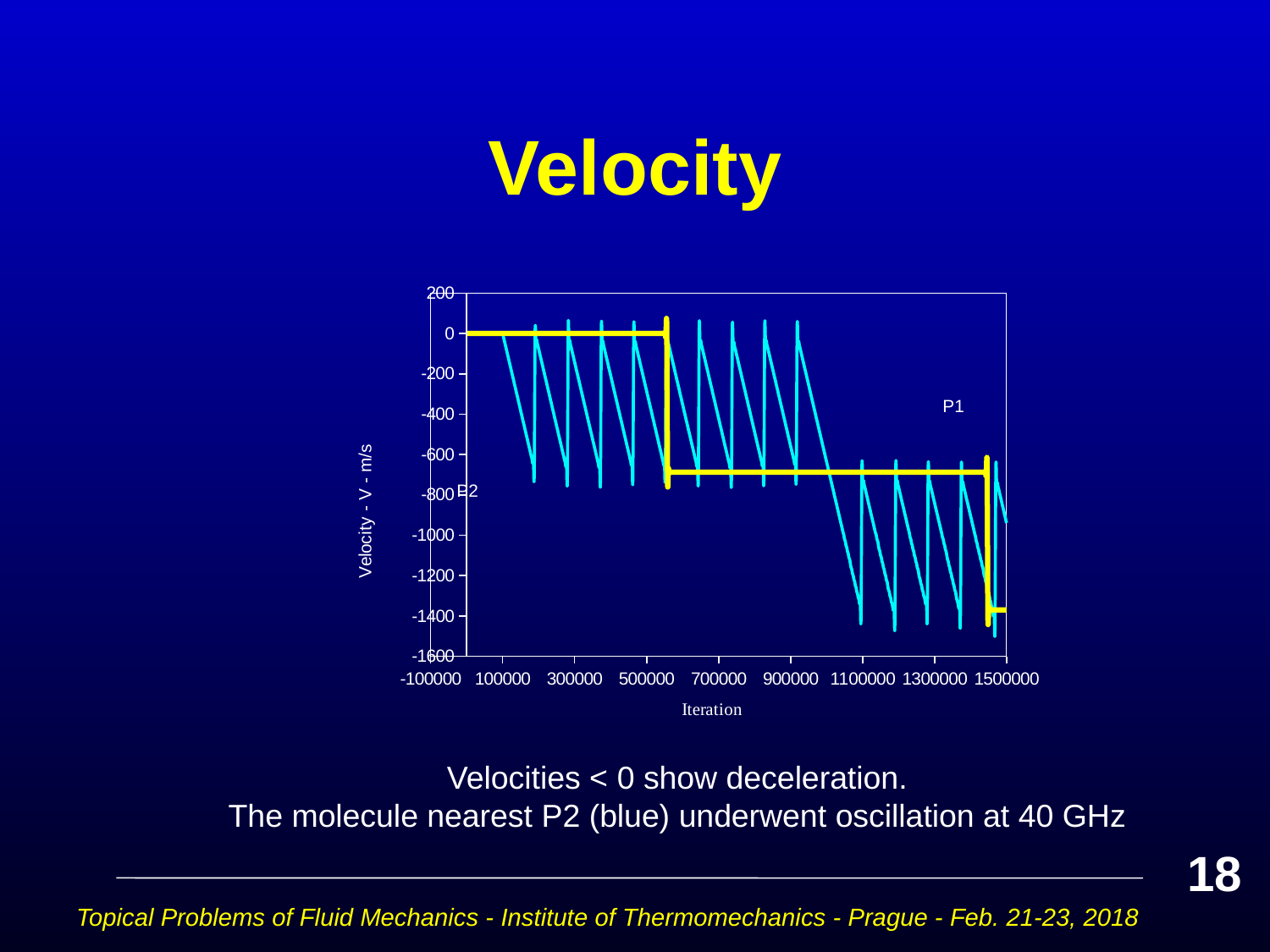
How many series are plotted in the chart? 2 What type of chart is shown on the slide? line chart Is the value of P1 at iteration 300000 greater or less than -200? greater Is the lowest value reached by P2 greater or less than -1200? less Does the P1 series rise or fall as the iteration increases? fall Is the value of P1 at iteration 1500000 greater or less than -1200? less Which series, P1 or P2, shows the sawtooth oscillation? P2 What is the title of the horizontal axis of the chart? Iteration What is the title of the vertical axis of the chart? Velocity - V - m/s